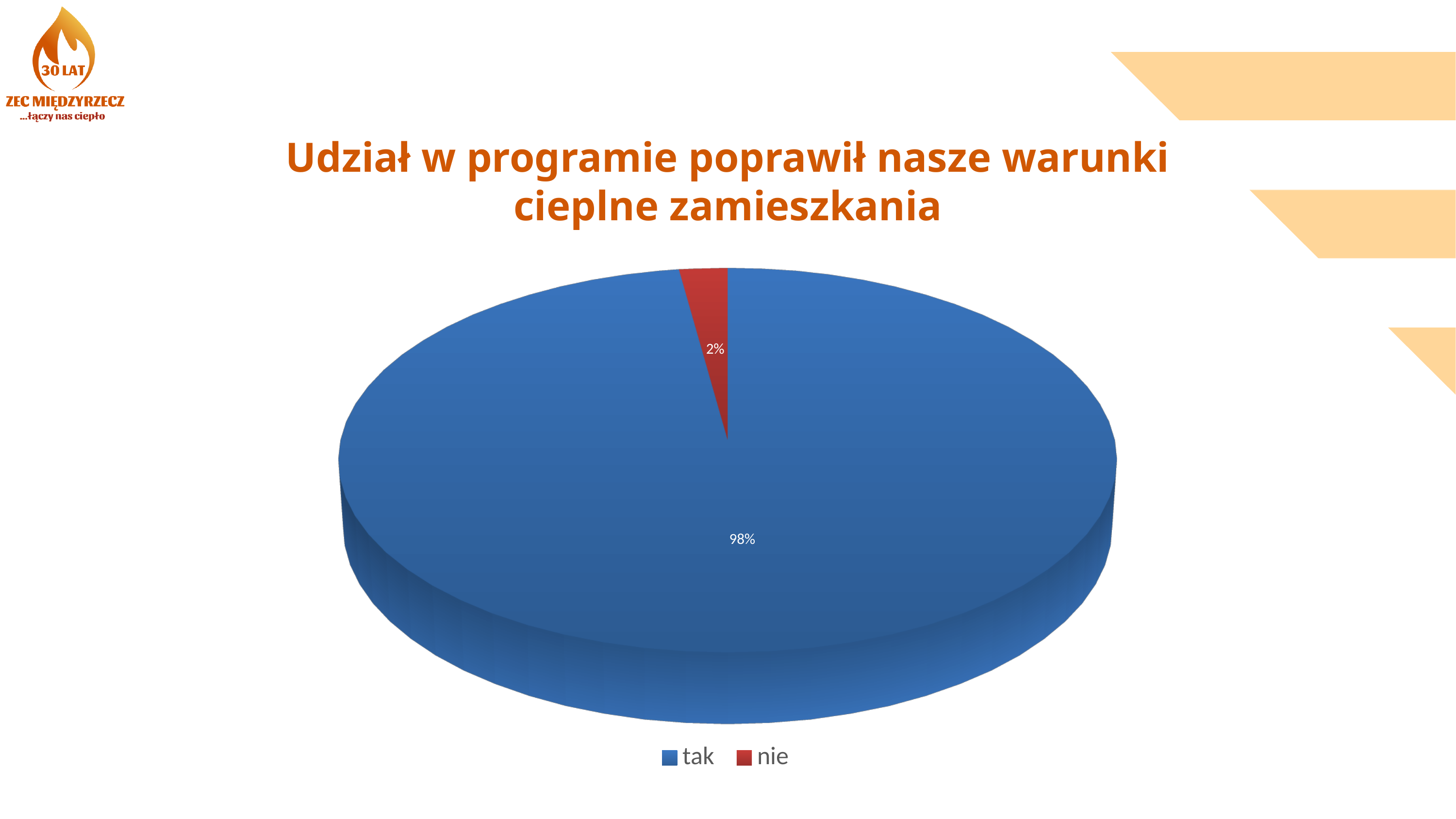
What share of the pie does "tak" represent? 98% How many slices does the pie chart have? 2 How many entries does the legend list? 2 What colour is the "nie" slice? red What is the difference in percentage points between the "tak" and "nie" shares? 96 What kind of chart is shown on the slide? pie chart Which category has the smallest slice of the pie? nie What share of the pie does "nie" represent? 2% Which category has the largest slice of the pie? tak What is the title of the chart? Udział w programie poprawił nasze warunki cieplne zamieszkania Which is larger, the share for "tak" or the share for "nie"? tak